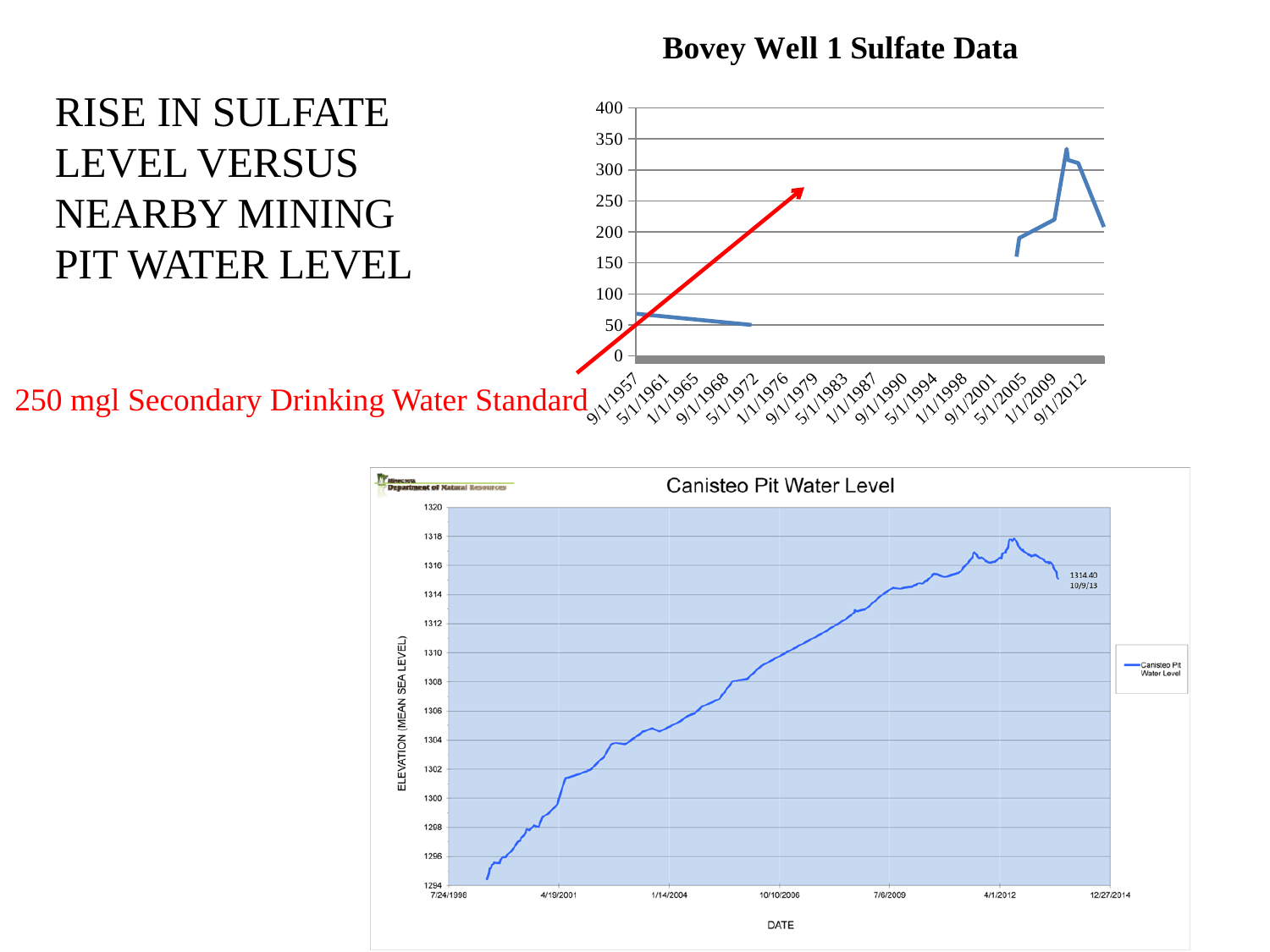
In the Canisteo Pit Water Level chart, what date is shown for the last labeled data point? 10/9/13 In the Bovey Well 1 Sulfate Data chart, is the first value of the later segment (around 5/1/2005) greater or less than 200? less In the Canisteo Pit Water Level chart, what is the labeled elevation of the last data point? 1314.40 In the Canisteo Pit Water Level chart, is the peak water level greater or less than 1316? greater In the Bovey Well 1 Sulfate Data chart, which is larger: the value at 9/1/2012 or the value at 9/1/1957? 9/1/2012 What kind of chart is the Bovey Well 1 Sulfate Data chart? line chart In the Bovey Well 1 Sulfate Data chart, is the highest sulfate value greater or less than 300? greater In the Canisteo Pit Water Level chart, does the water level generally rise or fall from 1999 to 2012? rise In the Bovey Well 1 Sulfate Data chart, do the values rise or fall between 5/1/2005 and 1/1/2009? rise What kind of chart is the Canisteo Pit Water Level chart? line chart How many series does the legend of the Canisteo Pit Water Level chart list? 1